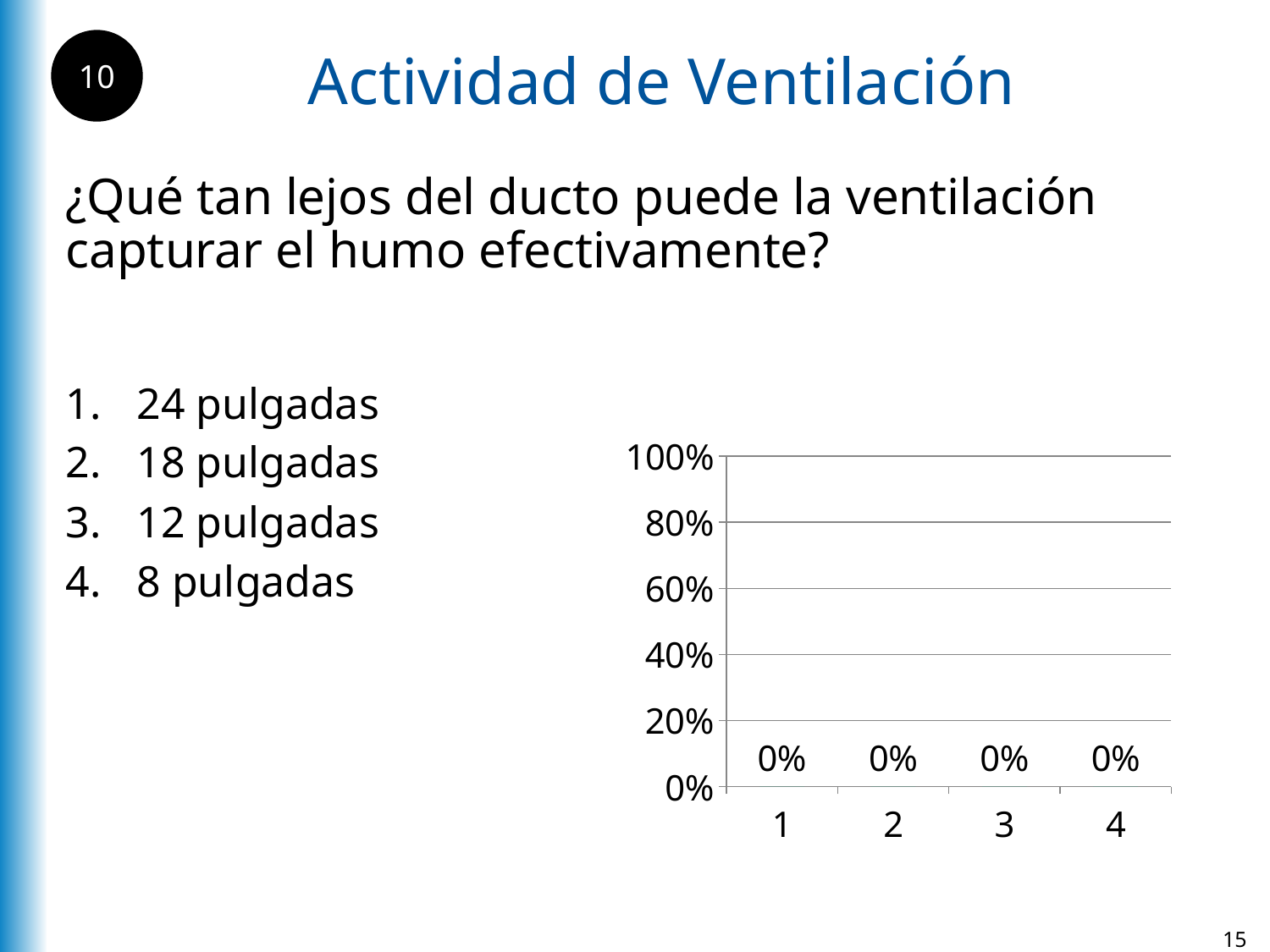
Is the value for category 1 greater or less than 20%? less What kind of chart is shown on the slide? bar chart What is the value shown for category 2? 0% What is the lowest value labelled on the y axis of the chart? 0% What is the value shown for category 4? 0% What is the difference between the values for category 1 and category 2? 0% Is the value for category 4 greater or less than 40%? less What is the highest value labelled on the y axis of the chart? 100% How many categories are shown on the x axis of the chart? 4 What is the value shown for category 3? 0% What is the value shown for category 1? 0%